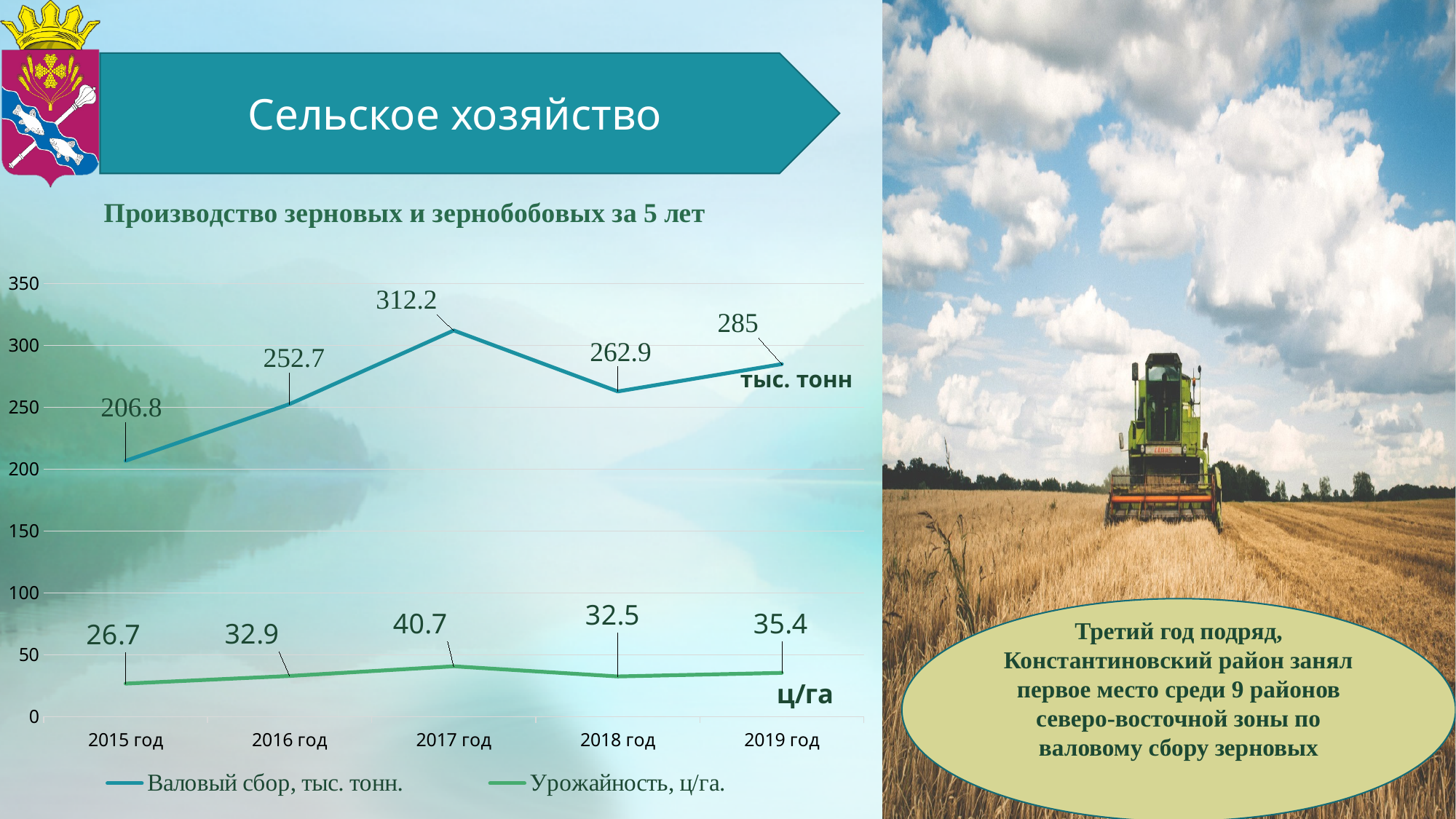
Which is larger: Урожайность, ц/га in 2016 год or in 2018 год? 2016 год How many series does the legend list? 2 What type of chart is shown on the slide? line chart What is the value of Валовый сбор, тыс. тонн for 2017 год? 312.2 Does Валовый сбор, тыс. тонн rise or fall from 2015 год to 2017 год? rise In which year is Урожайность, ц/га the highest? 2017 год What is the title of the chart? Производство зерновых и зернобобовых за 5 лет What is the value of Урожайность, ц/га for 2015 год? 26.7 What is the difference between Валовый сбор, тыс. тонн in 2017 год and 2018 год? 49.3 In which year is Валовый сбор, тыс. тонн the lowest? 2015 год What is the value of Валовый сбор, тыс. тонн for 2019 год? 285 How many years are plotted on the x axis? 5